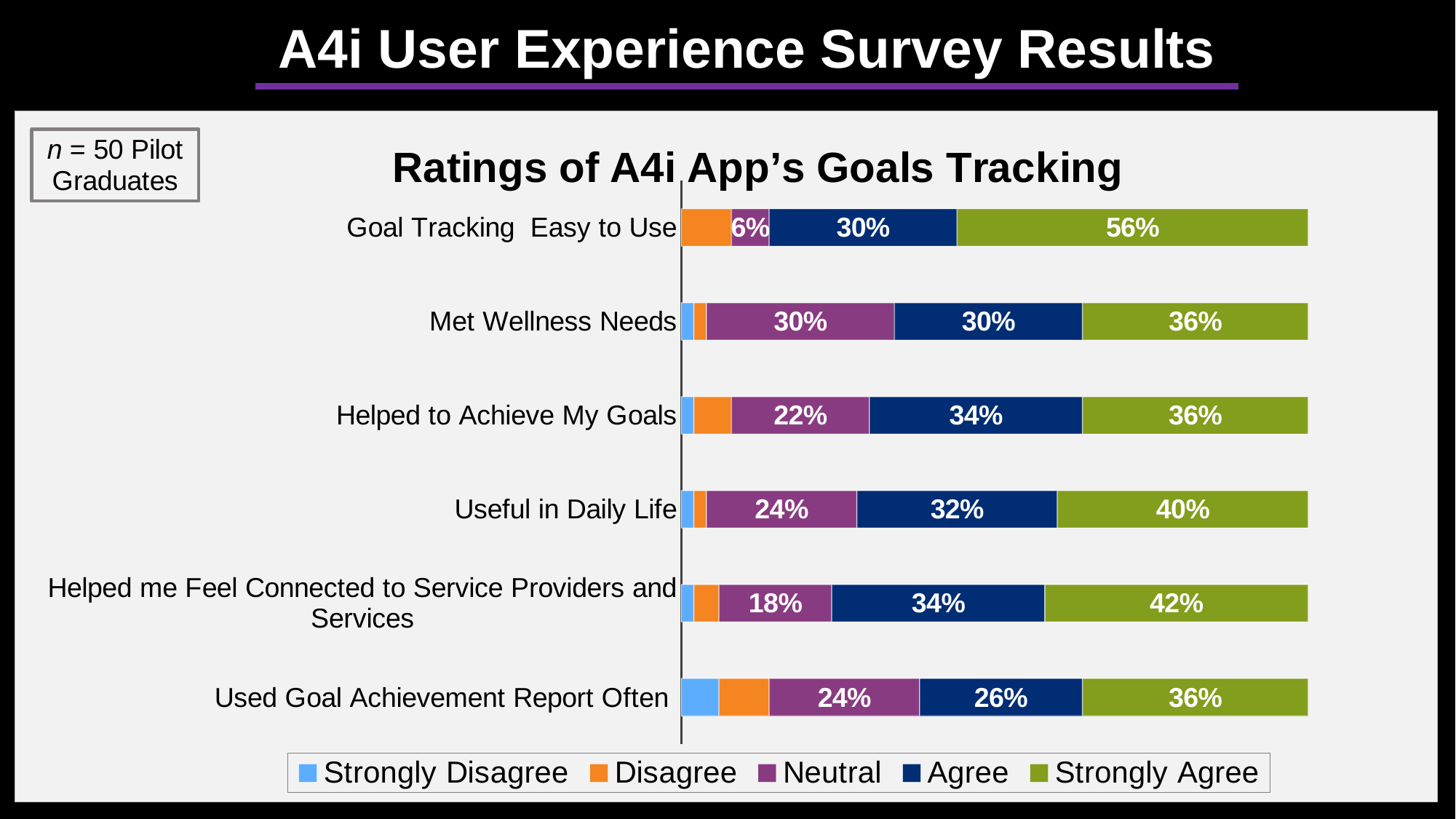
What is the Neutral value for Helped me Feel Connected to Service Providers and Services? 18% Which category has the highest Strongly Agree percentage? Goal Tracking Easy to Use Which has a larger Neutral value: Helped to Achieve My Goals or Useful in Daily Life? Useful in Daily Life How many survey statements (categories) are shown in the chart? 6 How many response categories does the legend list? 5 How many percentage points higher is the Strongly Agree value for Goal Tracking Easy to Use than for Met Wellness Needs? 20 percentage points What percentage of respondents Strongly Agree that Goal Tracking is Easy to Use? 56% What type of chart is shown on the slide? Stacked bar chart For Useful in Daily Life, what is the difference between the Strongly Agree and Agree values? 8 percentage points Which category has the lowest Agree percentage? Used Goal Achievement Report Often What is the Agree value for Met Wellness Needs? 30% What is the Agree value for Used Goal Achievement Report Often? 26%